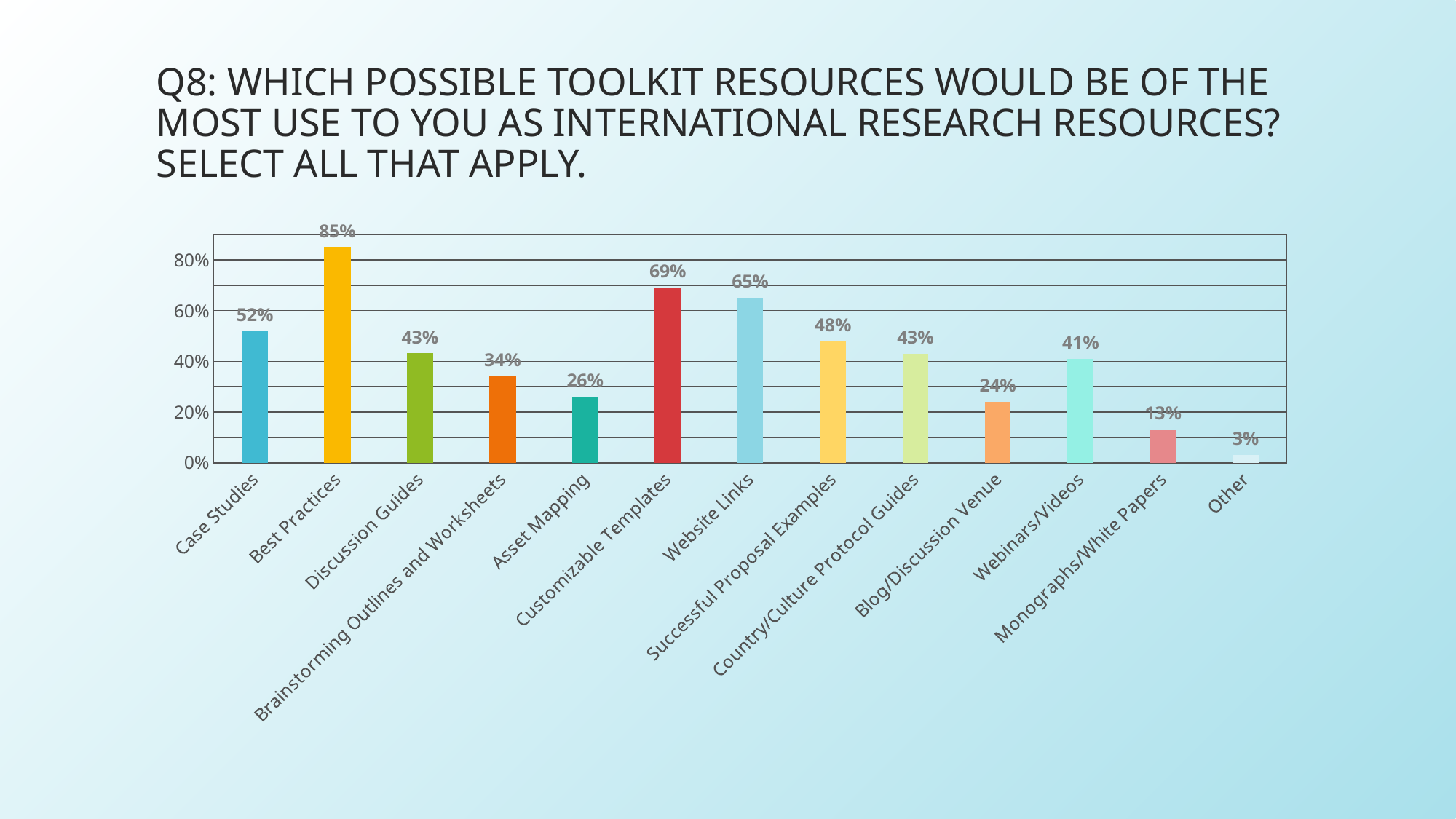
What is the value for Blog/Discussion Venue? 24% Which category has the highest value? Best Practices Is the value for Webinars/Videos greater or less than 40%? greater What is the difference between the values for Best Practices and Website Links? 20% What is the value for Best Practices? 85% What is the value for Customizable Templates? 69% What is the difference between the values for Discussion Guides and Asset Mapping? 17% How many categories are shown on the chart? 13 Which is larger, the value for Case Studies or the value for Successful Proposal Examples? Case Studies What is the value for Monographs/White Papers? 13% What kind of chart is shown on the slide? Bar chart Which category has the lowest value? Other